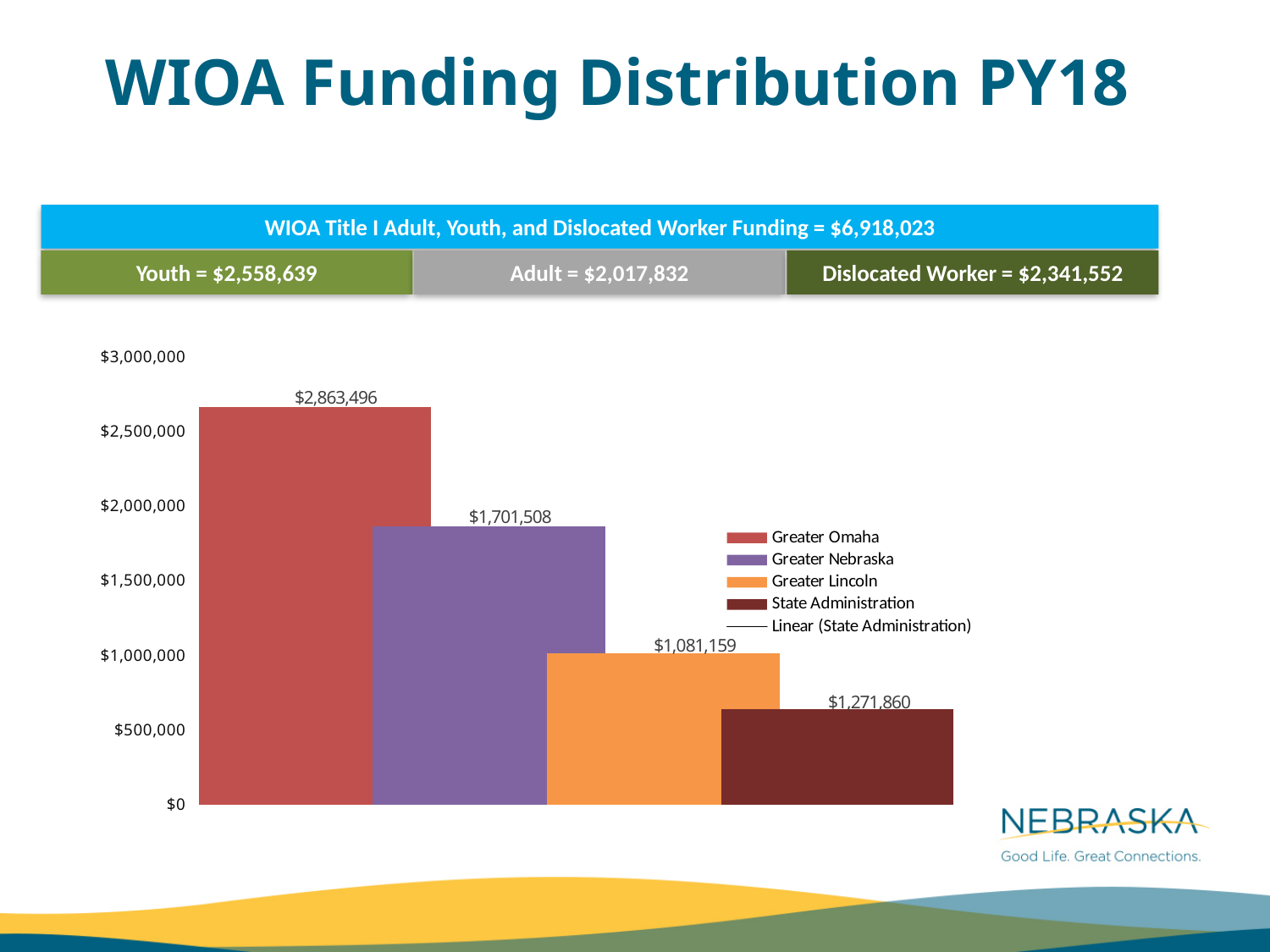
Is the value for Greater Omaha greater or less than $2,500,000? greater Which is larger, the value for Greater Omaha or the value for Greater Nebraska? Greater Omaha What is the value shown for Greater Nebraska? $1,701,508 How many entries does the chart legend list? 5 What is the value shown for State Administration? $1,271,860 What kind of chart is shown on the slide? bar chart How many bars are plotted in the chart? 4 What is the value shown for Greater Lincoln? $1,081,159 Which category has the highest value in the chart? Greater Omaha What is the value shown for Greater Omaha? $2,863,496 What is the difference between the values for Greater Nebraska and Greater Lincoln? $620,349 What is the difference between the values for Greater Omaha and Greater Nebraska? $1,161,988